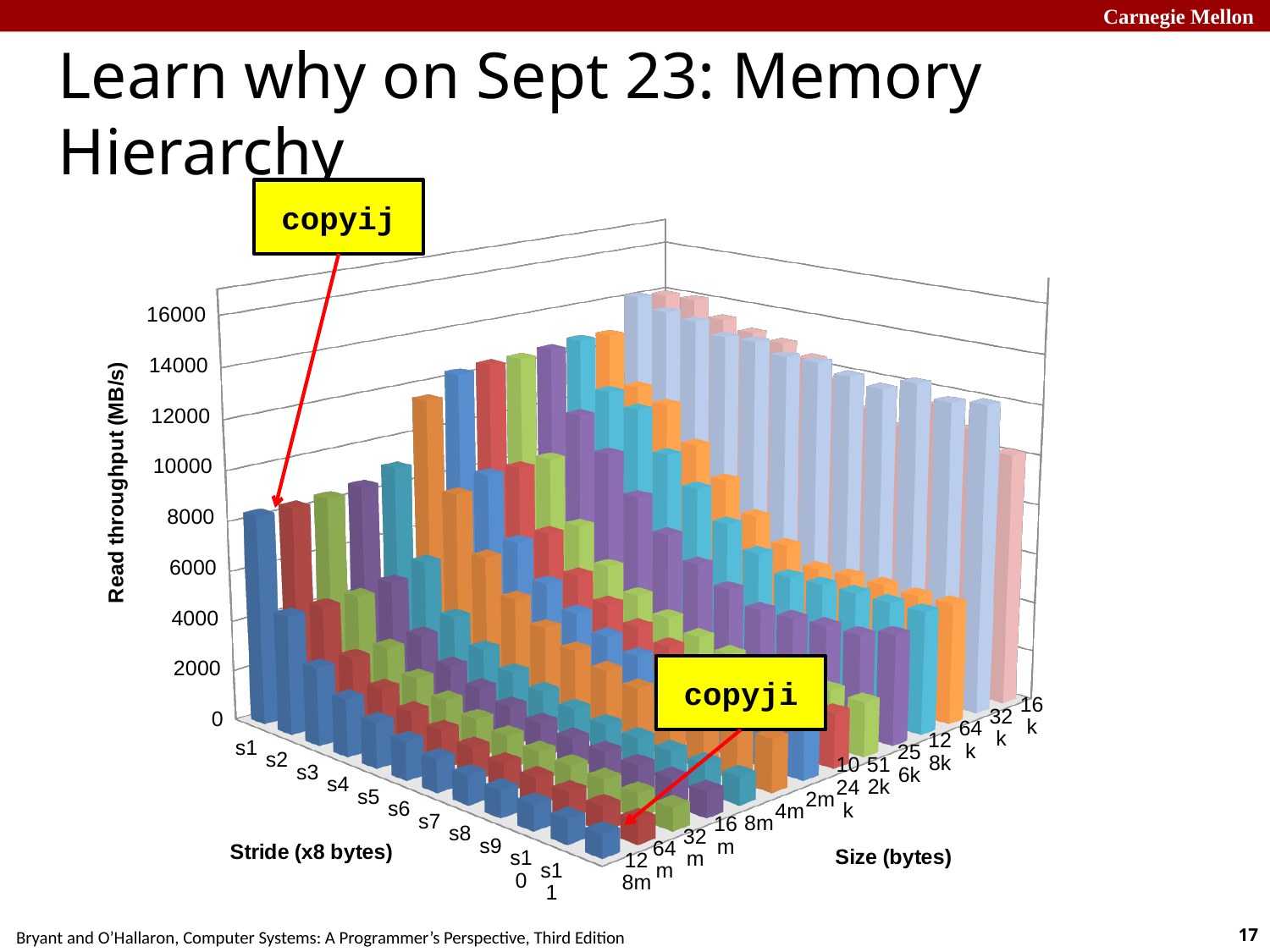
Which has the higher read throughput, the bar labeled copyij or the bar labeled copyji? copyij Is the read throughput for the bar labeled copyji greater or less than 2000? less For size 128m, does read throughput rise or fall as the stride increases from s1 to s11? fall What kind of chart is shown on the slide? bar chart What are the titles of the two horizontal axes of the chart? Stride (x8 bytes) and Size (bytes) How many stride categories are shown along the stride axis? 11 How many size categories are shown along the size axis? 14 For stride s1, does read throughput rise or fall as the size decreases from 128m to 16k? rise Is the read throughput for stride s1 at size 16k greater or less than 12000? greater What is the title of the vertical axis of the chart? Read throughput (MB/s) Is the read throughput for the bar labeled copyij greater or less than 10000? less